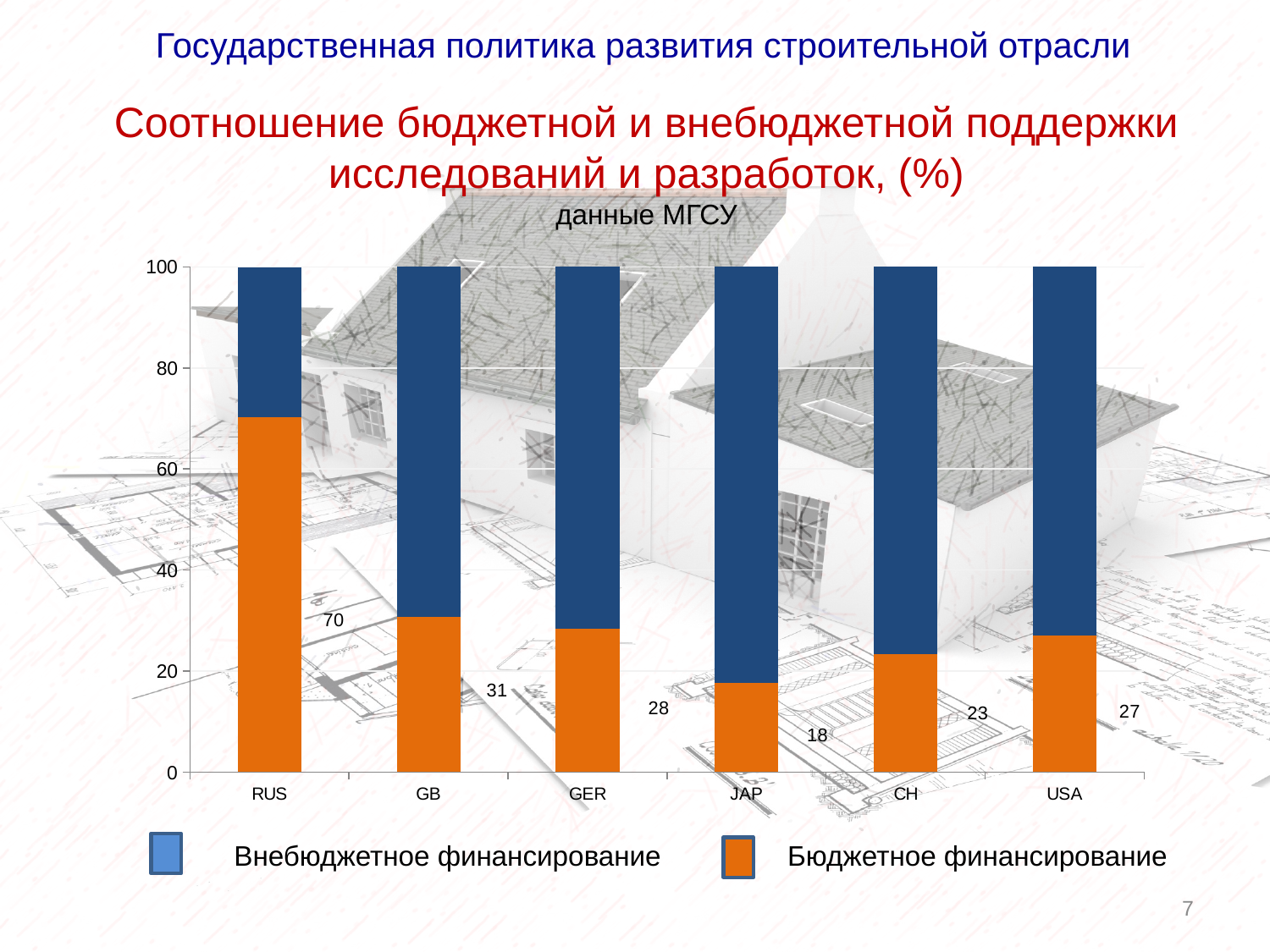
Which country has the highest budget financing share? RUS Which country has the lowest budget financing share? JAP What is the budget financing (Бюджетное финансирование) value for RUS? 70 What is the budget financing value for USA? 27 Is the extra-budgetary financing value for JAP greater or less than 80? greater Is the extra-budgetary financing (Внебюджетное финансирование) value for RUS greater or less than 40? less How many series does the legend list? 2 What kind of chart is shown on the slide? stacked bar chart Which has a larger budget financing value, GER or CH? GER What is the budget financing value for JAP? 18 How many countries are shown on the x axis? 6 What is the difference between the budget financing values for RUS and GB? 39